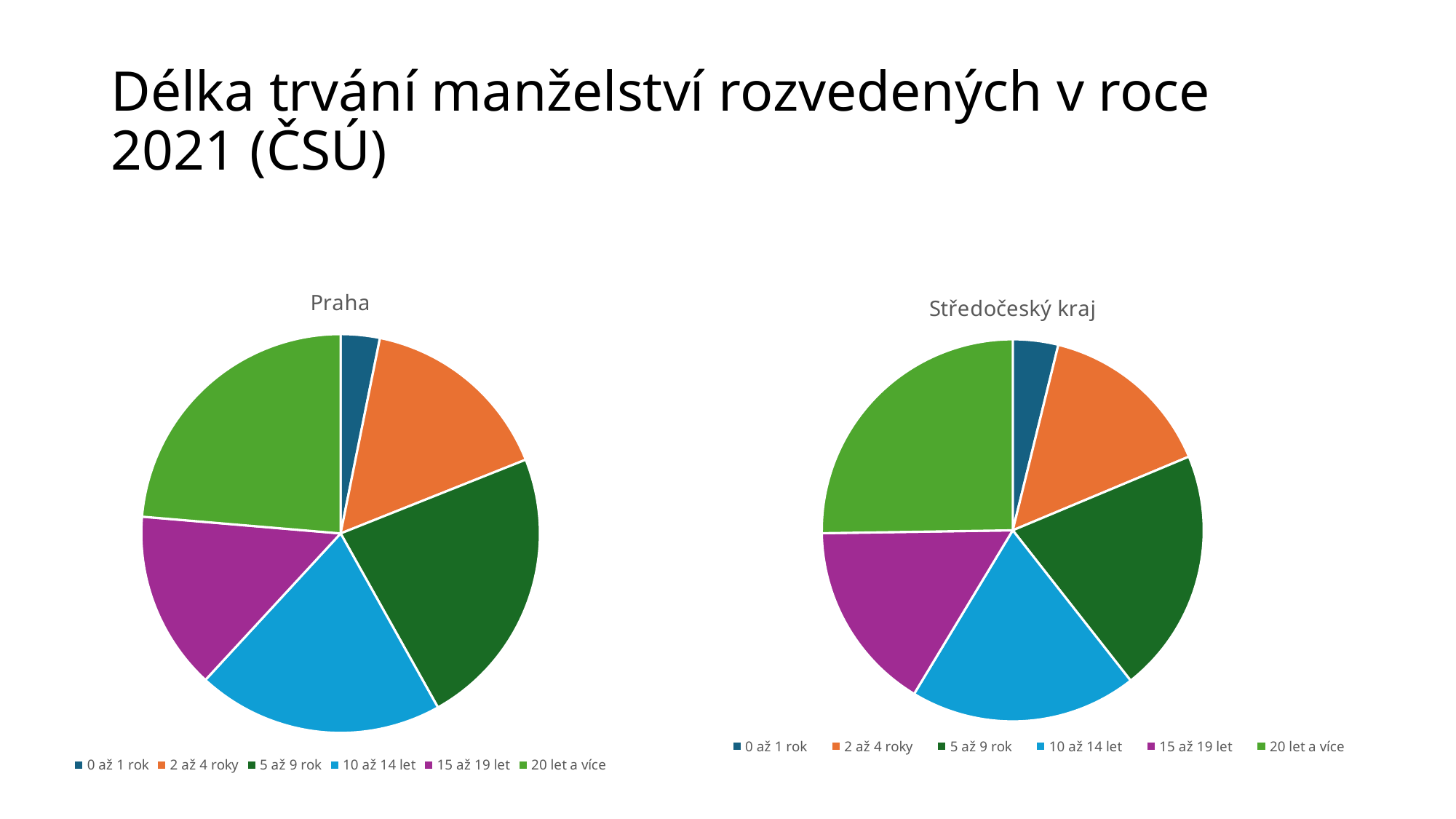
What kind of chart is the Středočeský kraj chart? pie chart In the Středočeský kraj chart, which slice is larger: 0 až 1 rok or 15 až 19 let? 15 až 19 let In the Praha chart, which slice is larger: 5 až 9 rok or 2 až 4 roky? 5 až 9 rok In the Středočeský kraj chart, which category has the smallest slice? 0 až 1 rok In the Praha chart, which category has the smallest slice? 0 až 1 rok What is the title of the pie chart on the left? Praha Which colour represents the category 20 let a více in the legend? green In the Středočeský kraj chart, which slice is larger: 20 let a více or 2 až 4 roky? 20 let a více What kind of chart is the Praha chart? pie chart How many categories does the legend of the Středočeský kraj chart list? 6 How many slices does the Praha pie chart have? 6